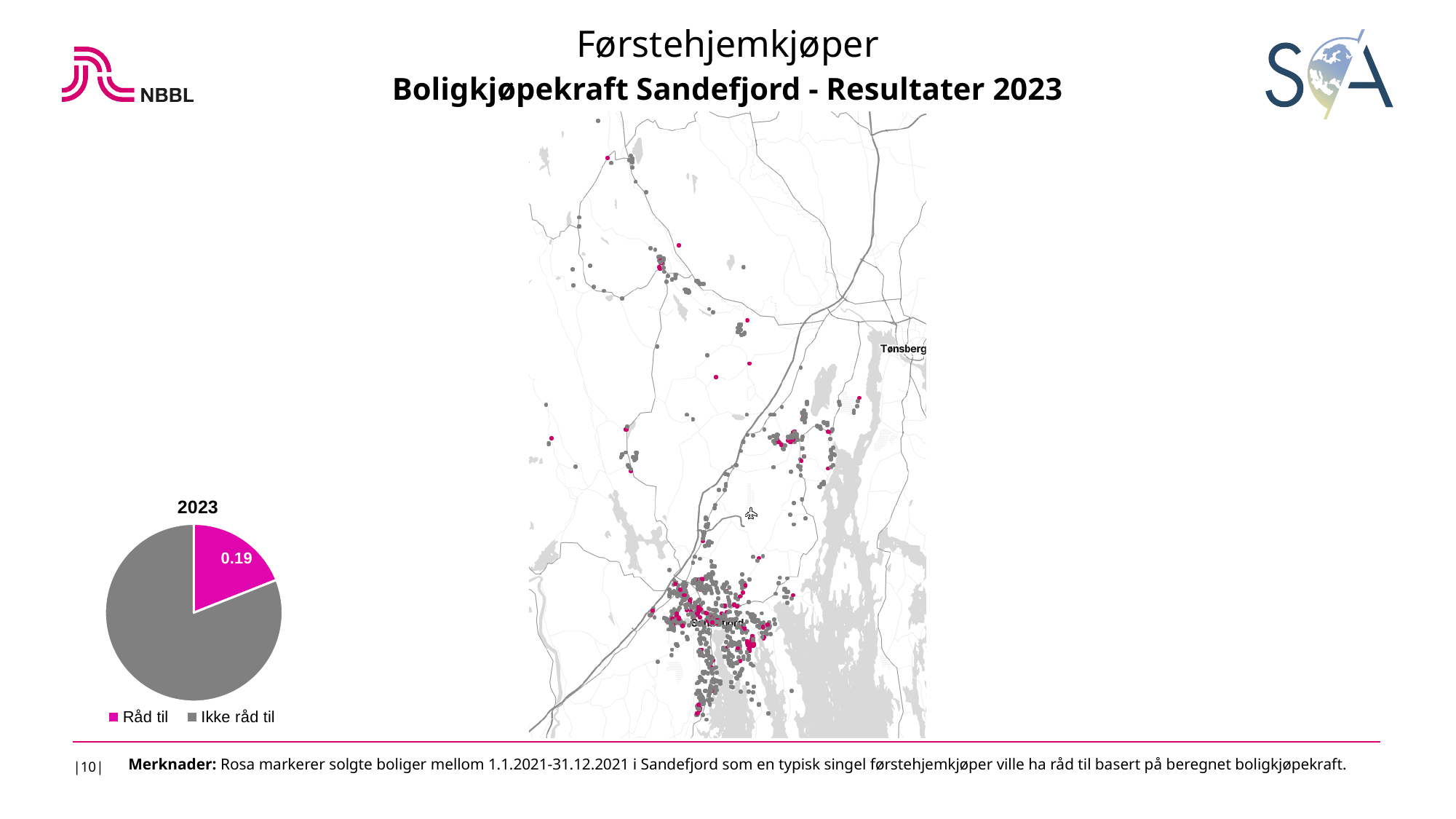
What is the title of the pie chart? 2023 In the pie chart, what share of the pie does "Råd til" represent? 0.19 In the pie chart, what colour is the "Råd til" slice? pink What kind of chart is the chart on the left of the slide? pie chart How many entries does the legend of the pie chart list? 2 In the pie chart, what value is shown for the "Råd til" slice? 0.19 In the pie chart, which category has the largest slice? Ikke råd til In the pie chart, which is larger: "Råd til" or "Ikke råd til"? Ikke råd til In the pie chart, which category has the smallest slice? Råd til How many slices does the pie chart have? 2